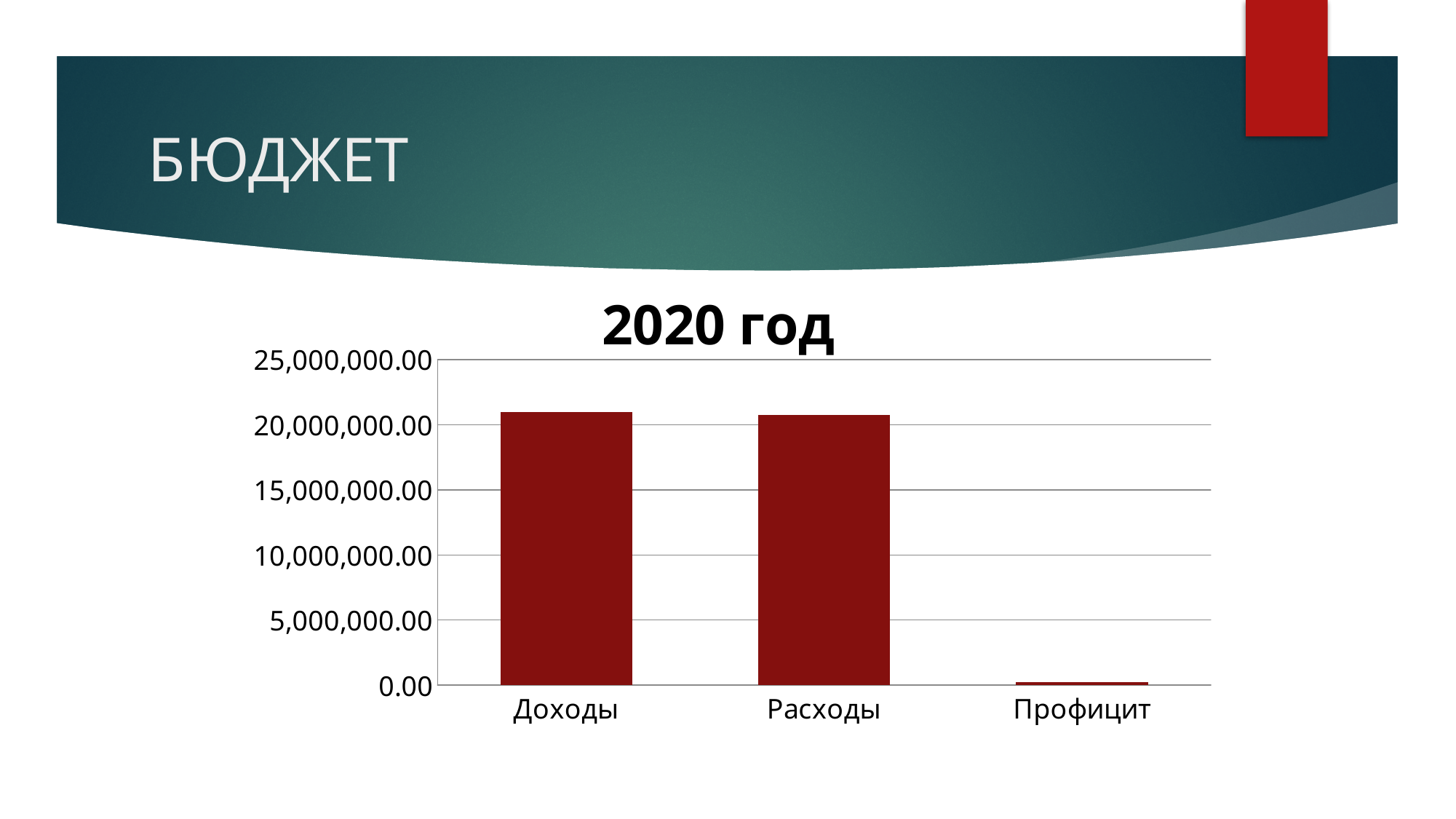
Which is larger, the value for Расходы or the value for Профицит? Расходы Is the value for Доходы greater or less than 25,000,000.00? less How many categories are shown on the x axis of the chart? 3 Is the value for Профицит greater or less than 5,000,000.00? less Is the value for Доходы greater or less than 20,000,000.00? greater What kind of chart is shown on the slide? bar chart What is the title of the chart? 2020 год Which category has the lowest value in the chart? Профицит What is the highest value shown on the y axis of the chart? 25,000,000.00 Which is larger, the value for Доходы or the value for Профицит? Доходы